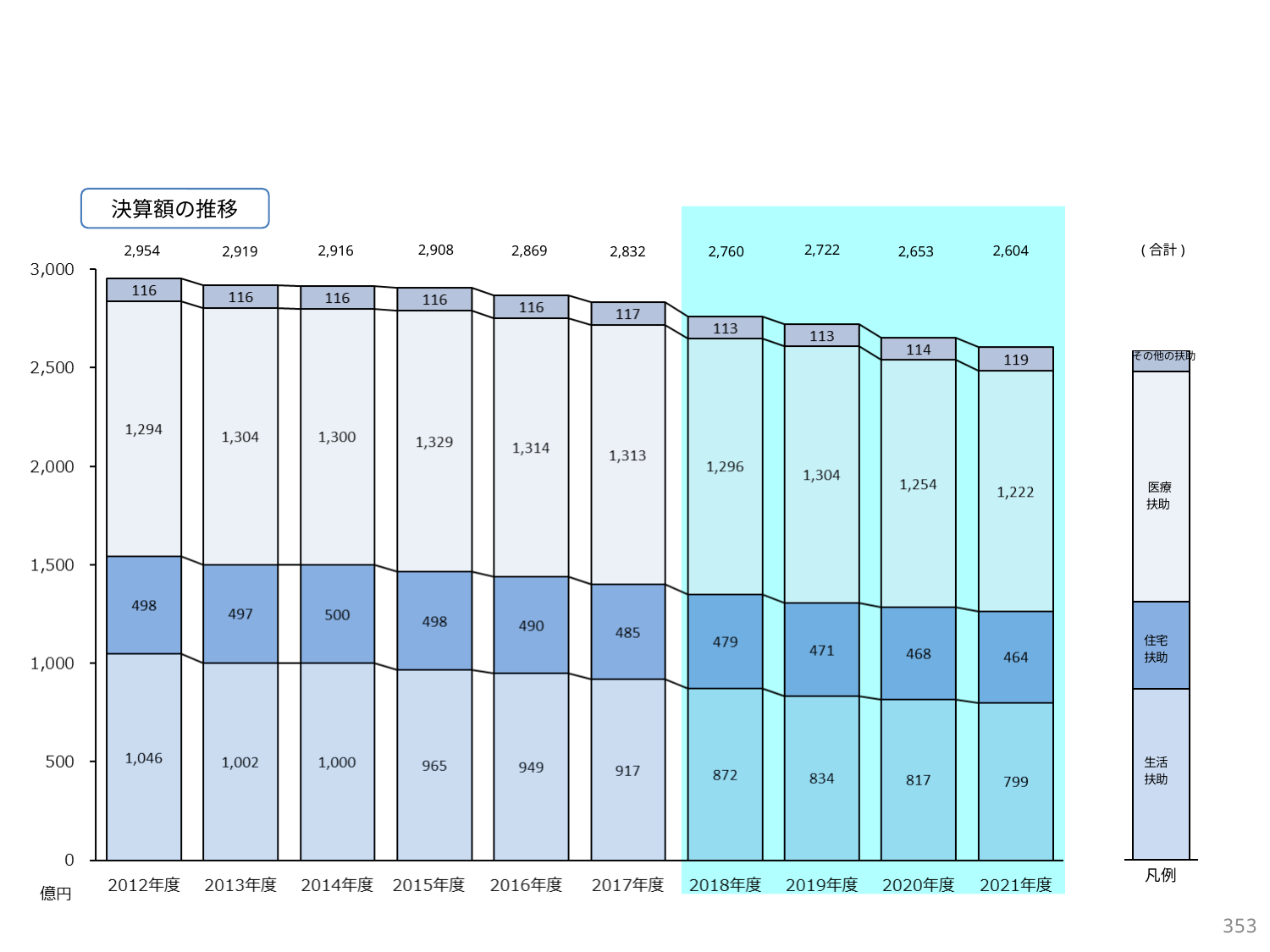
What is the 住宅扶助 value for 2014年度? 500 How many segment types does the legend (凡例) list? 4 How many years (categories) are shown on the x axis? 10 What is the total (合計) value shown for 2012年度? 2,954 Do the total (合計) values rise or fall from 2012年度 to 2021年度? Fall What is the 医療扶助 value for 2015年度? 1,329 What kind of chart is this? Stacked bar chart What is the difference between the 生活扶助 values for 2012年度 and 2021年度? 247 What is the 生活扶助 value for 2021年度? 799 Which year has the lowest 生活扶助 value? 2021年度 Which is larger, the 医療扶助 value for 2019年度 or for 2020年度? 2019年度 Which year has the highest total (合計)? 2012年度